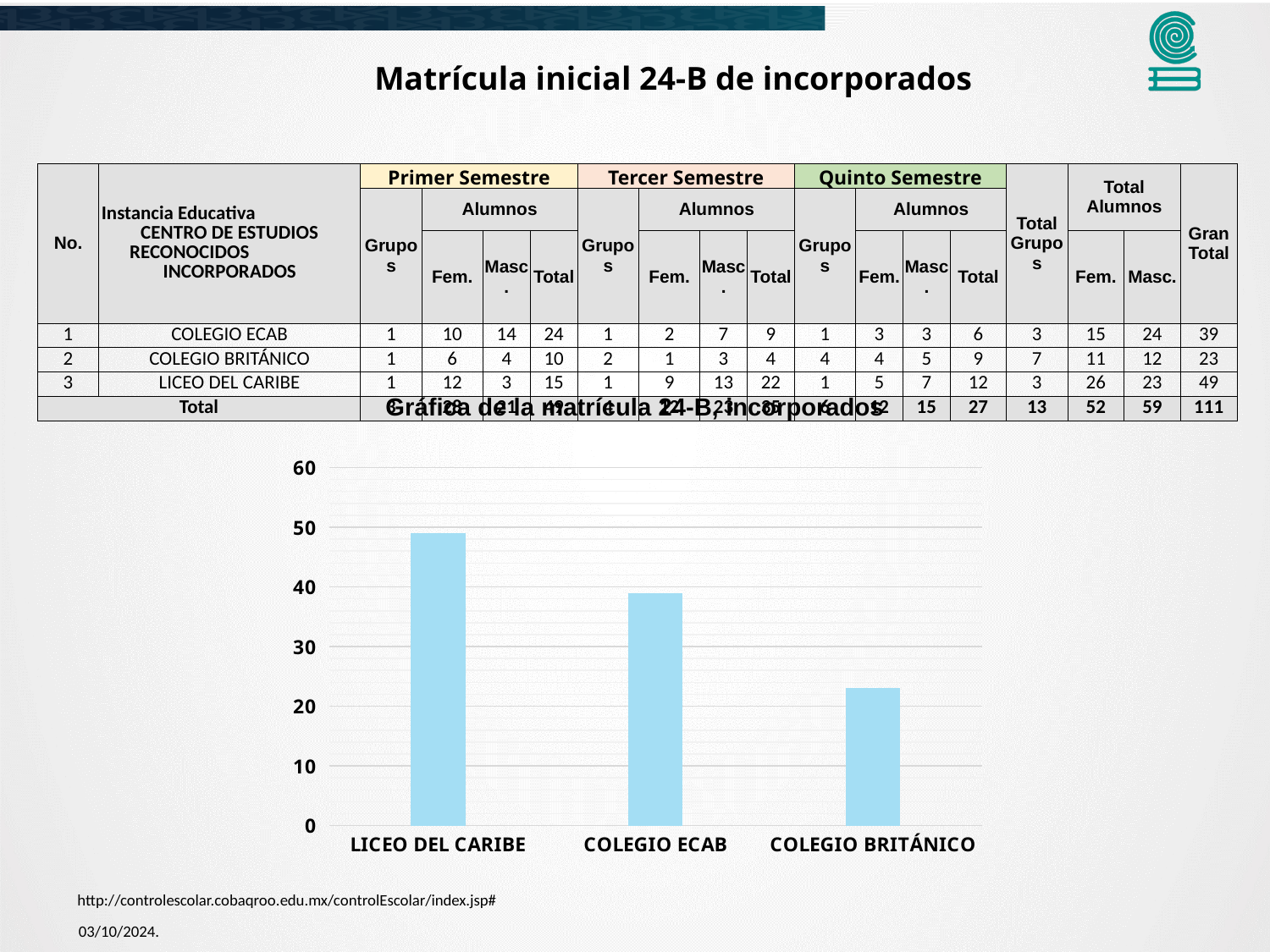
What is the maximum value shown on the chart's vertical axis? 60 What colour are the bars in the chart? light blue Is the value for COLEGIO ECAB greater or less than 30? greater Do the bar values rise or fall from left to right along the x axis? fall Which category has the highest bar in the chart? LICEO DEL CARIBE Which is larger, the bar for COLEGIO ECAB or the bar for COLEGIO BRITÁNICO? COLEGIO ECAB Is the value for LICEO DEL CARIBE greater or less than 40? greater Is the value for COLEGIO BRITÁNICO greater or less than 30? less What kind of chart is shown on the slide? bar chart How many categories are plotted in the bar chart? 3 Which category has the lowest bar in the chart? COLEGIO BRITÁNICO